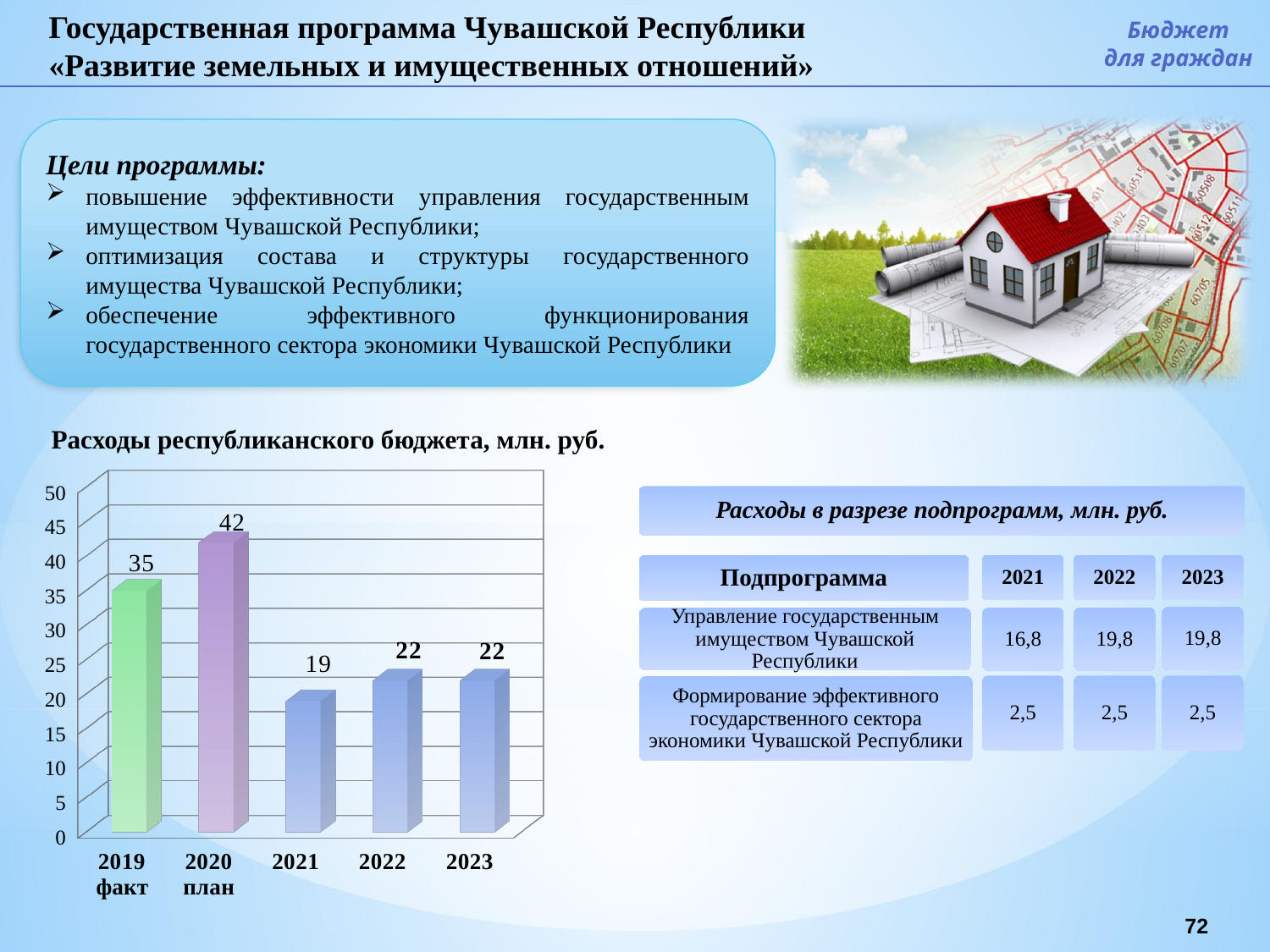
What type of chart is used to show 'Расходы республиканского бюджета, млн. руб.'? bar chart What is the value for 2020 план in the chart 'Расходы республиканского бюджета, млн. руб.'? 42 What is the value for 2019 факт in the chart 'Расходы республиканского бюджета, млн. руб.'? 35 What is the value for 2021 in the chart 'Расходы республиканского бюджета, млн. руб.'? 19 What is the difference between the values for 2022 and 2021 in the chart 'Расходы республиканского бюджета, млн. руб.'? 3 Which category has the highest value in the chart 'Расходы республиканского бюджета, млн. руб.'? 2020 план Which is larger in the chart 'Расходы республиканского бюджета, млн. руб.': the value for 2019 факт or the value for 2021? 2019 факт How many categories are shown on the x axis of the chart 'Расходы республиканского бюджета, млн. руб.'? 5 What is the difference between the values for 2020 план and 2019 факт in the chart 'Расходы республиканского бюджета, млн. руб.'? 7 What is the value for 2023 in the chart 'Расходы республиканского бюджета, млн. руб.'? 22 Which category has the lowest value in the chart 'Расходы республиканского бюджета, млн. руб.'? 2021 What is the maximum value shown on the y axis of the chart 'Расходы республиканского бюджета, млн. руб.'? 50